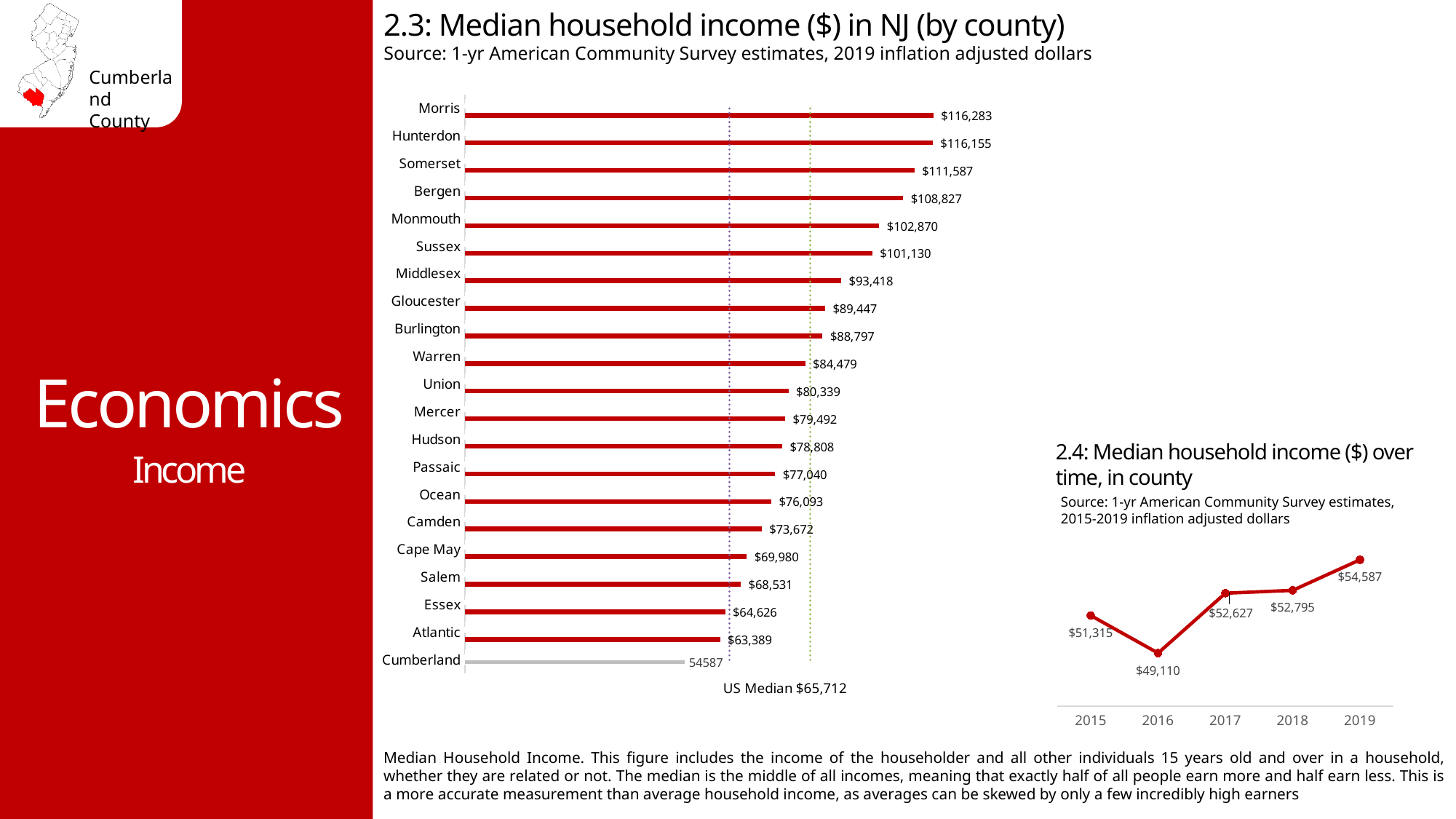
In chart 2.4 (Median household income over time, in county), what is the median household income in 2016? $49,110 In chart 2.3 (Median household income in NJ by county), which county has the lowest median household income? Cumberland In chart 2.3 (Median household income in NJ by county), what is the difference between the median household income of Morris and Cumberland? $61,696 In chart 2.3 (Median household income in NJ by county), which county has the highest median household income? Morris In chart 2.3 (Median household income in NJ by county), what US Median value is labelled on the chart? $65,712 In chart 2.4 (Median household income over time, in county), what is the difference between the 2019 and 2015 values? $3,272 What kind of chart is chart 2.3 (Median household income in NJ by county)? Bar chart In chart 2.4 (Median household income over time, in county), which year has the highest median household income? 2019 In chart 2.3 (Median household income in NJ by county), what is the median household income for Gloucester? $89,447 In chart 2.3 (Median household income in NJ by county), which has a higher median household income, Bergen or Monmouth? Bergen In chart 2.3 (Median household income in NJ by county), what is the median household income for Cumberland? 54587 In chart 2.3 (Median household income in NJ by county), how many counties are shown? 21